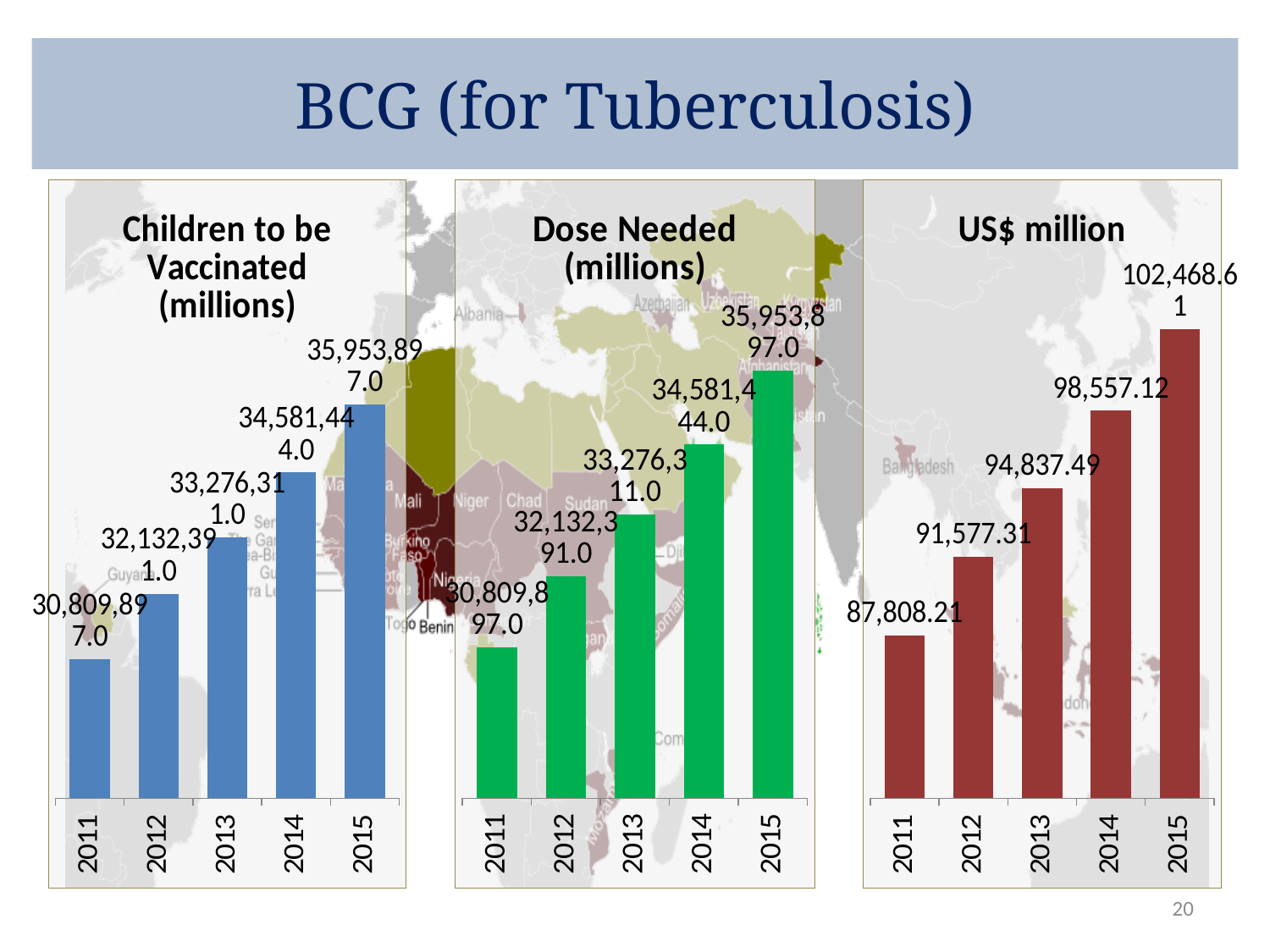
In the Children to be Vaccinated (millions) chart, which year has the lowest value? 2011 What colour are the bars in the Dose Needed (millions) chart? Green What kind of chart is the Children to be Vaccinated (millions) chart? Bar chart In the US$ million chart, which year has the highest value? 2015 In the US$ million chart, what is the value for 2013? 94,837.49 In the US$ million chart, what is the difference between the 2015 and 2011 values? 14,660.40 In the US$ million chart, what is the difference between the 2012 and 2011 values? 3,769.10 How many years are shown on the x axis of the Dose Needed (millions) chart? 5 In the US$ million chart, do the values rise or fall from 2011 to 2015? Rise In the US$ million chart, what is the value for 2011? 87,808.21 In the Dose Needed (millions) chart, which is larger, the value for 2013 or the value for 2014? 2014 In the US$ million chart, what is the value for 2014? 98,557.12